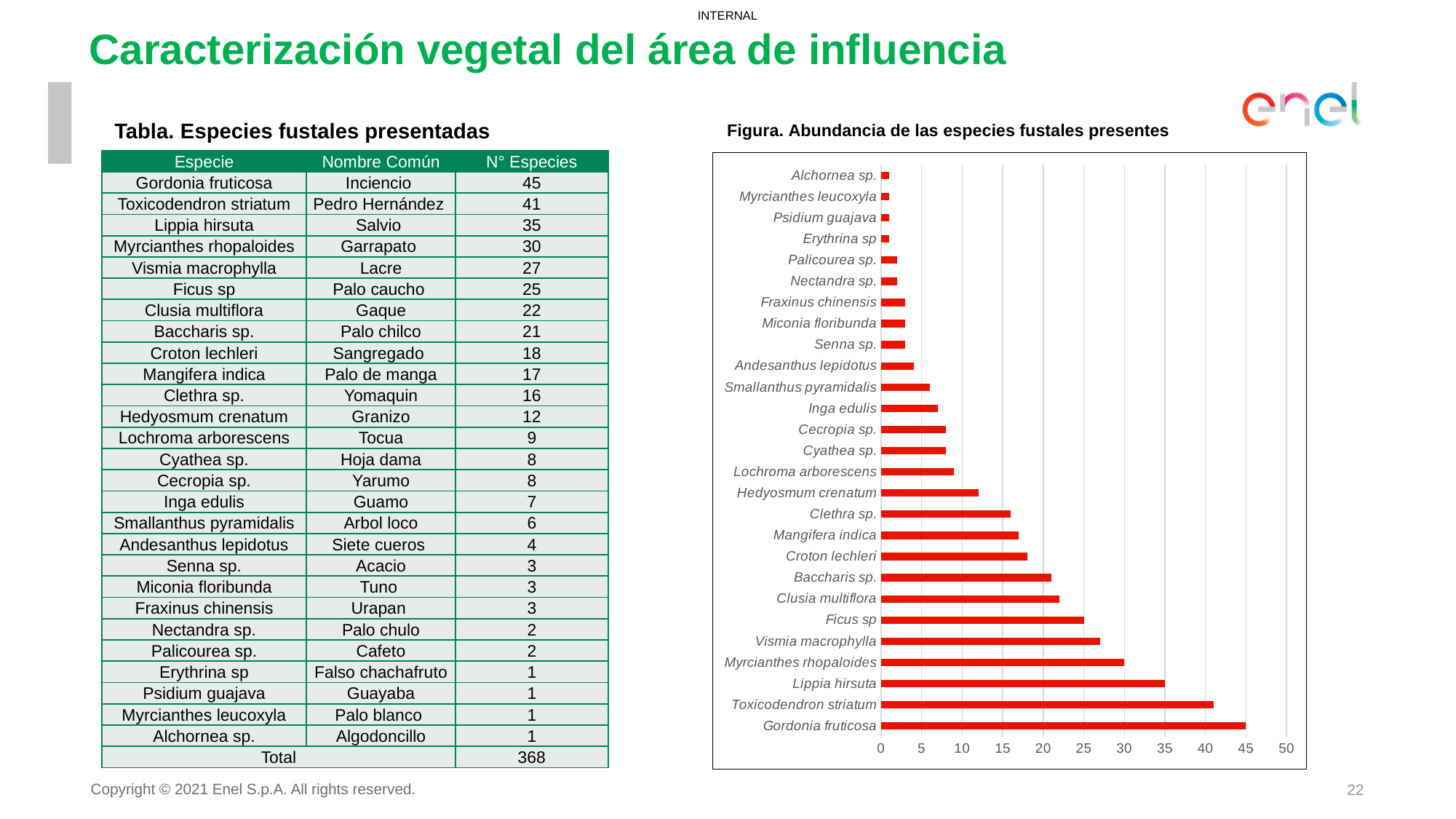
In the bar chart, is the value for Toxicodendron striatum greater or less than 40? greater In the bar chart, which is larger, the value for Lippia hirsuta or for Myrcianthes rhopaloides? Lippia hirsuta In the bar chart, what is the value for Myrcianthes rhopaloides? 30 In the bar chart, is the value for Croton lechleri greater or less than 20? less How many species are plotted in the bar chart? 27 In the bar chart, what is the value for Lippia hirsuta? 35 In the bar chart, what is the value for Gordonia fruticosa? 45 What is the highest tick value shown on the horizontal axis of the bar chart? 50 In the bar chart, is the value for Hedyosmum crenatum greater or less than 10? greater In the bar chart, what is the difference between the values for Gordonia fruticosa and Lippia hirsuta? 10 What kind of chart is shown in the figure 'Abundancia de las especies fustales presentes'? Bar chart In the bar chart, which species has the highest abundance? Gordonia fruticosa